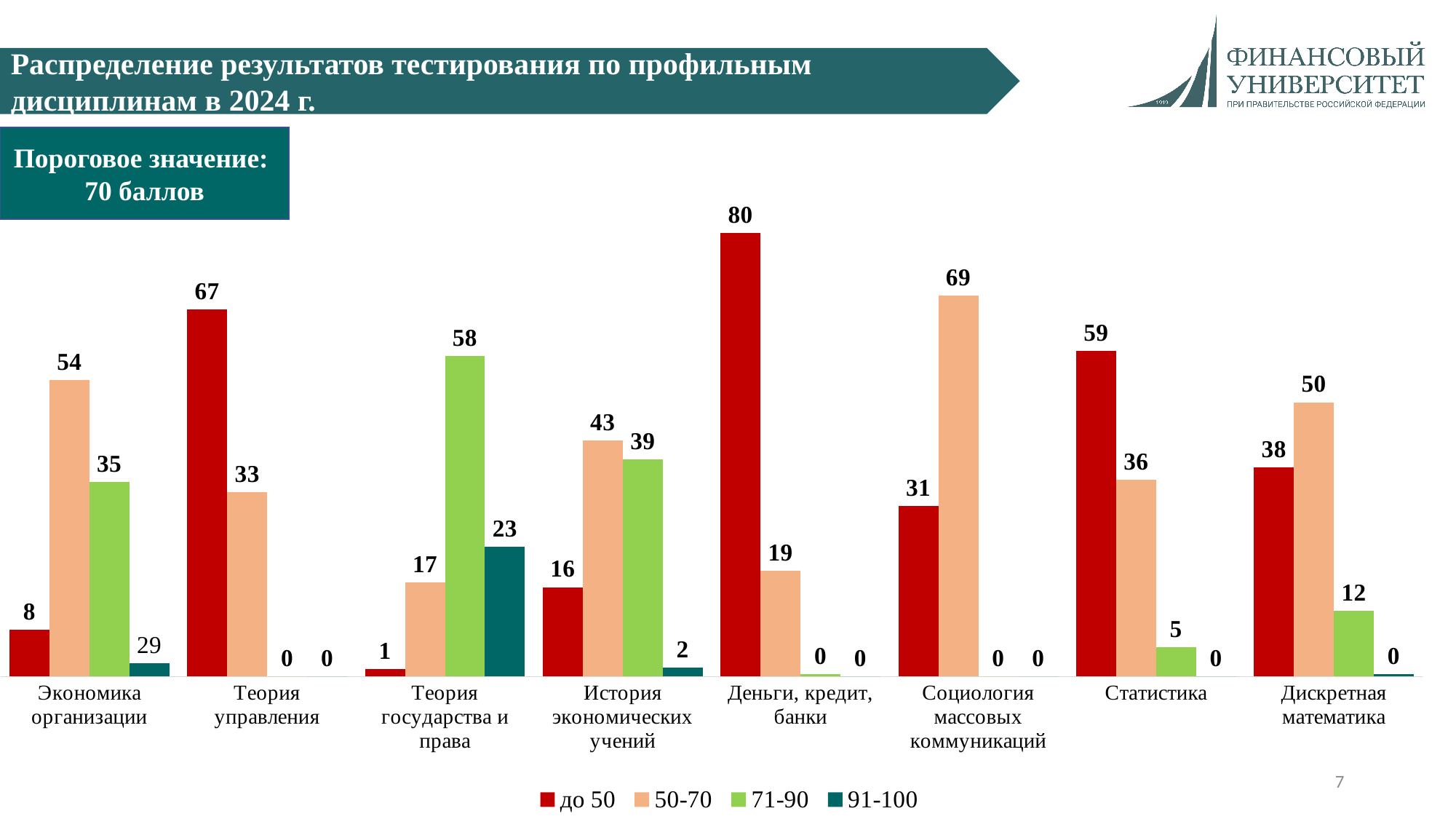
How many series does the legend list? 4 What is the difference between the 'до 50' and '50-70' values for 'Теория управления'? 34 What is the value of the 'до 50' series for 'Деньги, кредит, банки'? 80 What threshold value (пороговое значение) is stated on the slide? 70 баллов What is the value of the '71-90' series for 'Теория государства и права'? 58 For 'История экономических учений', which is larger: the '50-70' value or the '71-90' value? 50-70 What is the value of the '50-70' series for 'Социология массовых коммуникаций'? 69 How many discipline categories are shown on the x axis? 8 What type of chart is shown on the slide? bar chart What is the value of the '91-100' series for 'Теория государства и права'? 23 Which discipline has the lowest value in the 'до 50' series? Теория государства и права Which discipline has the highest value in the 'до 50' series? Деньги, кредит, банки